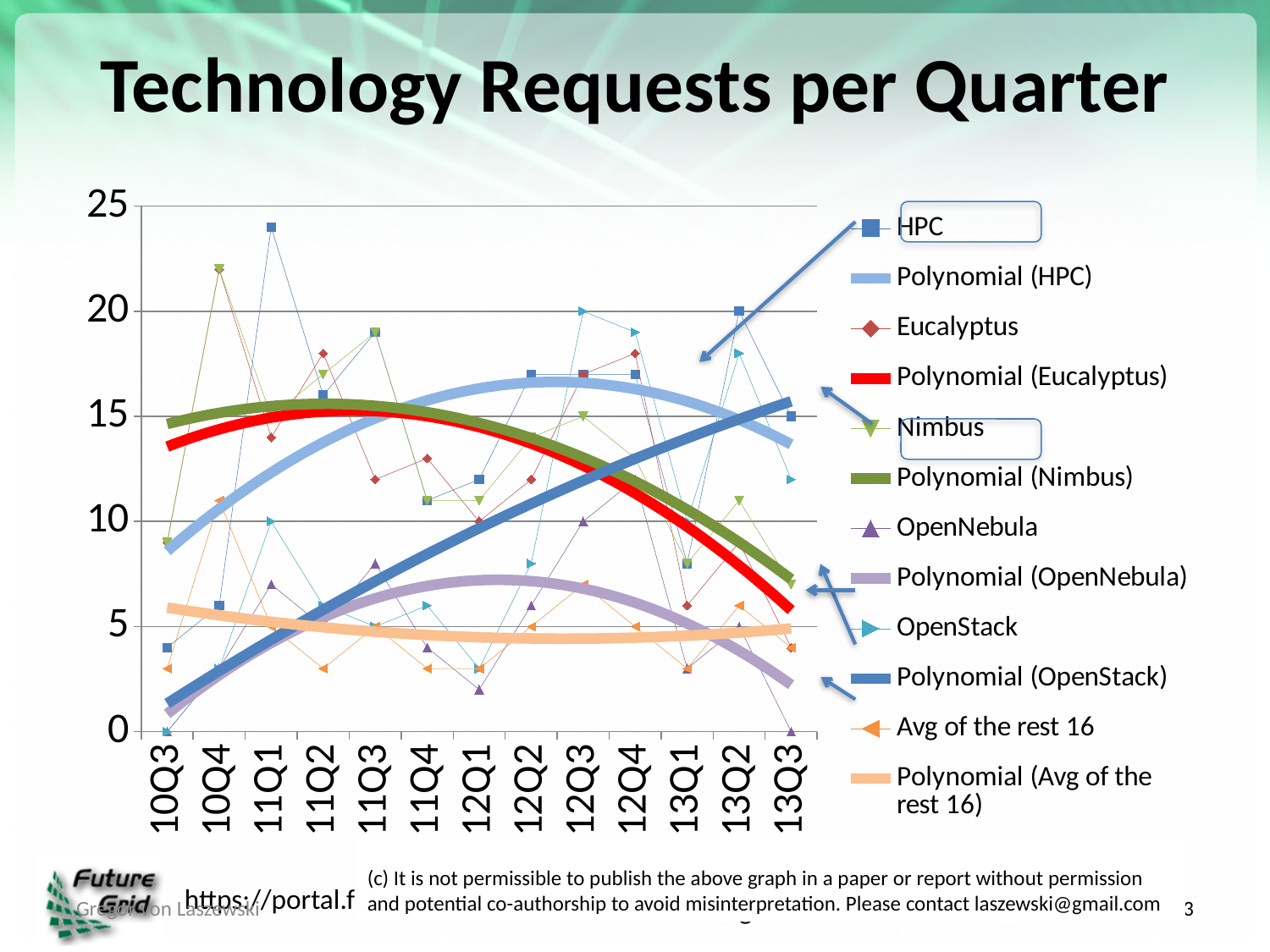
How many series does the legend list? 12 What is the title of the chart? Technology Requests per Quarter Is the value for HPC in 11Q1 greater or less than 20? greater In which quarter does the OpenStack series reach its highest value? 12Q3 Is the value for OpenStack in 12Q4 greater or less than 15? greater What kind of chart is shown on the slide? line chart How many quarters are shown along the x axis? 13 Which is larger in 10Q4, the value for Nimbus or the value for HPC? Nimbus In which quarter does the HPC series reach its highest value? 11Q1 Is the value for Nimbus in 10Q4 greater or less than 20? greater